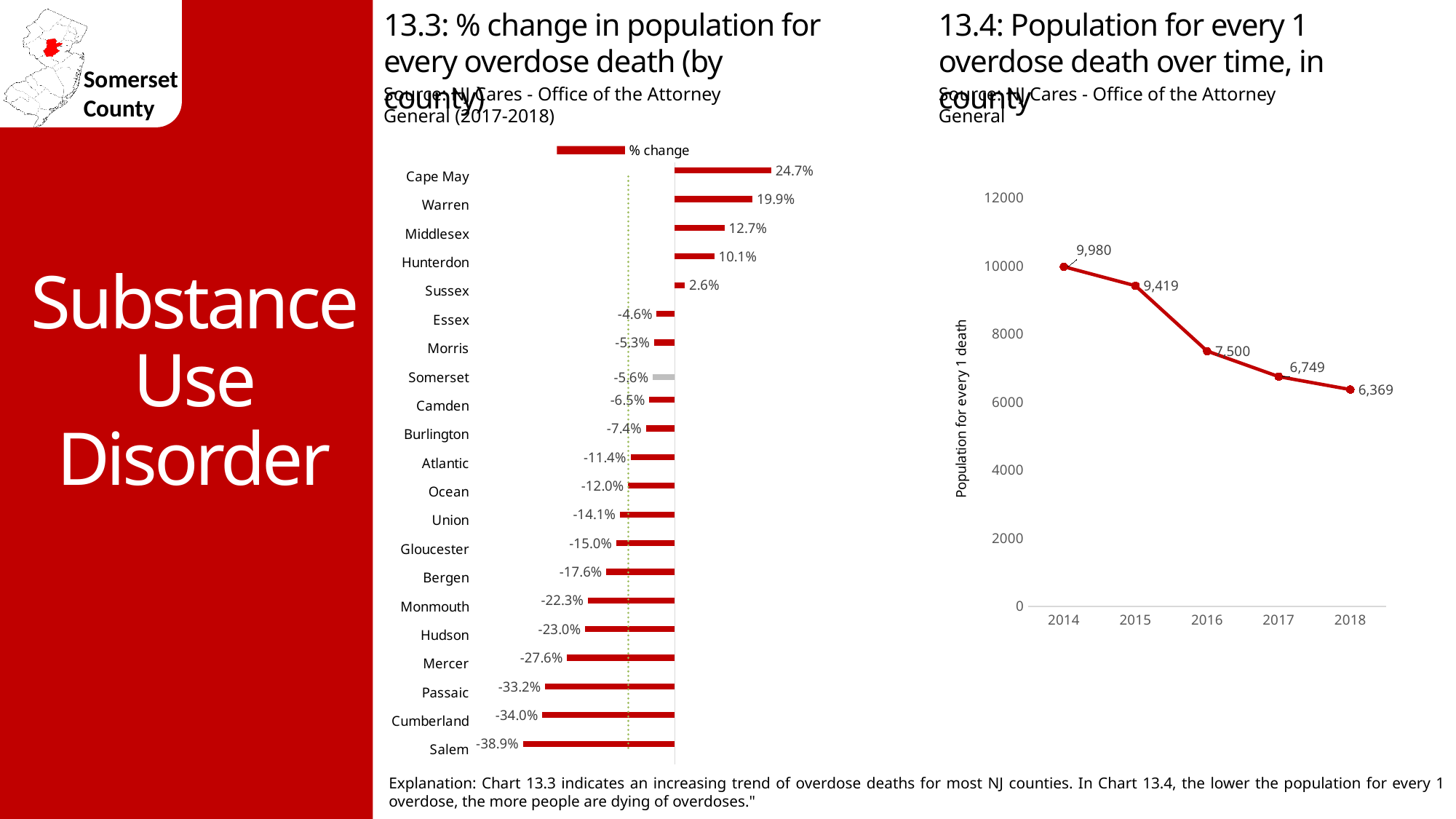
In chart 13.4, what is the population for every 1 overdose death in 2016? 7,500 In chart 13.4, what is the population for every 1 overdose death in 2018? 6,369 What kind of chart is chart 13.4? line chart In chart 13.3, what is the % change for Somerset? -5.6% In chart 13.3, what is the % change for Cape May? 24.7% In chart 13.3, how many counties are shown? 21 In chart 13.3, which county has the lowest % change? Salem In chart 13.3, what is the difference between the % change for Cape May and Warren? 4.8 percentage points In chart 13.3, which has a larger % change, Mercer or Hudson? Hudson In chart 13.3, which county has the highest % change? Cape May In chart 13.4, do the values rise or fall from 2014 to 2018? fall In chart 13.4, what is the difference between the 2014 and 2018 values? 3,611